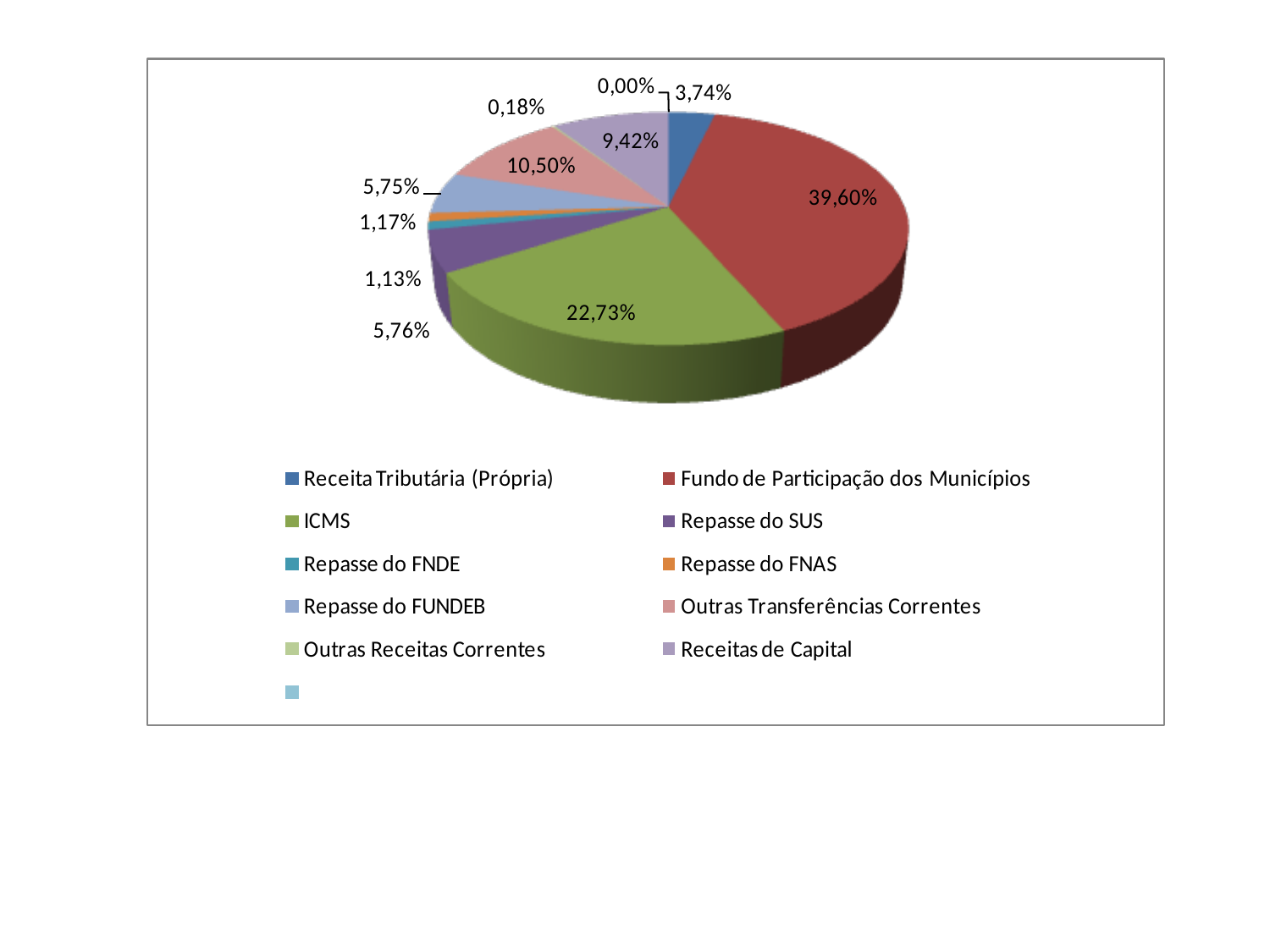
What is the value shown for ICMS? 22,73% What colour is the slice for ICMS? Green What is the value shown for Repasse do SUS? 5,76% What is the combined share of Fundo de Participação dos Municípios and ICMS? 62,33% What is the value shown for Receita Tributária (Própria)? 3,74% Which category has the largest slice of the pie? Fundo de Participação dos Municípios Which is larger, Outras Transferências Correntes or Receitas de Capital? Outras Transferências Correntes What is the value shown for Receitas de Capital? 9,42% What share of the pie does Fundo de Participação dos Municípios represent? 39,60% What is the value shown for Outras Transferências Correntes? 10,50% What is the difference between the shares of Fundo de Participação dos Municípios and ICMS? 16,87% What kind of chart is shown on the slide? Pie chart